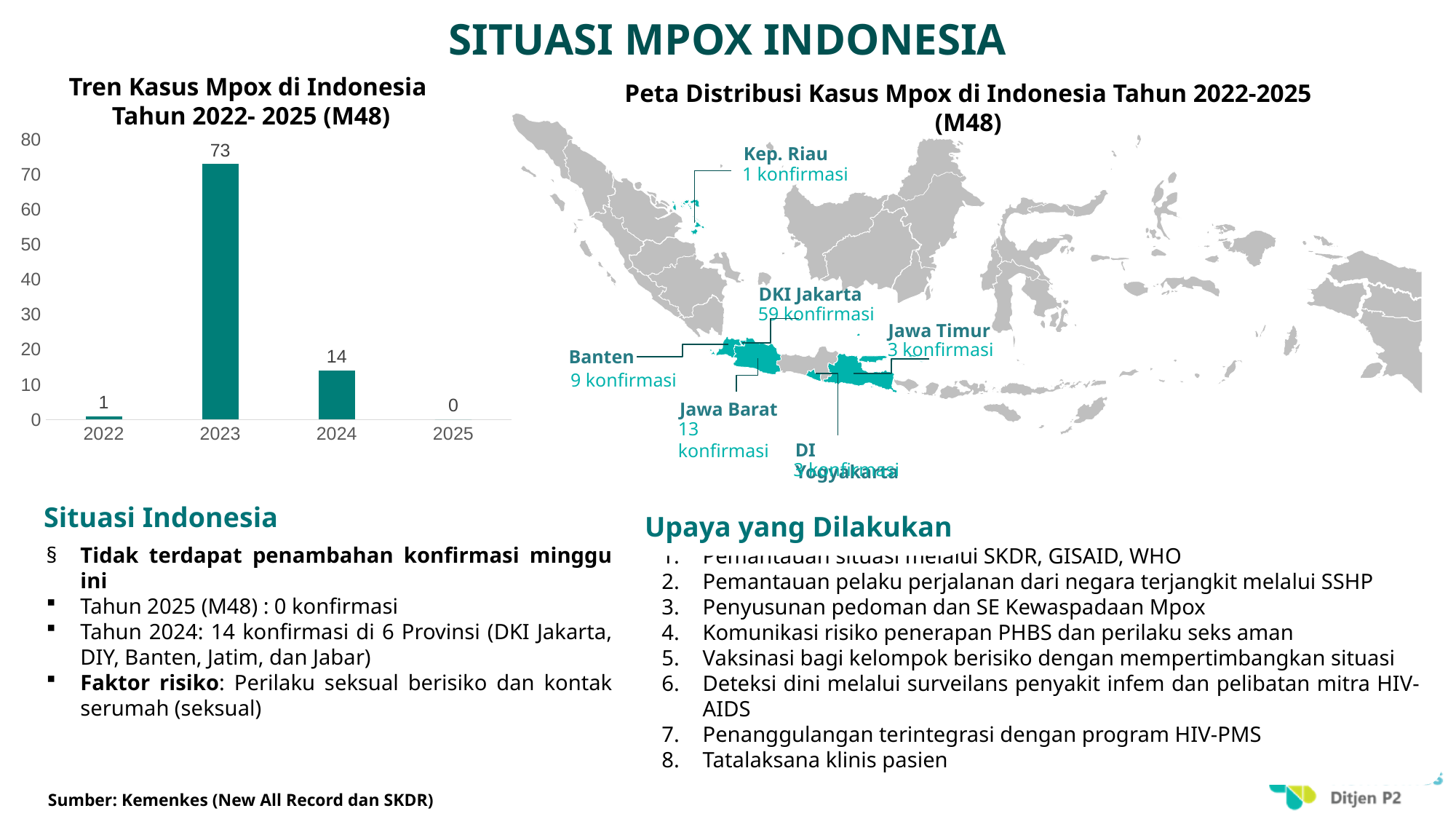
What kind of chart is 'Tren Kasus Mpox di Indonesia Tahun 2022-2025 (M48)'? bar chart In the bar chart 'Tren Kasus Mpox di Indonesia Tahun 2022-2025 (M48)', what is the value for 2025? 0 In the bar chart 'Tren Kasus Mpox di Indonesia Tahun 2022-2025 (M48)', what is the value for 2024? 14 In the bar chart 'Tren Kasus Mpox di Indonesia Tahun 2022-2025 (M48)', what is the value for 2023? 73 In the bar chart 'Tren Kasus Mpox di Indonesia Tahun 2022-2025 (M48)', what is the value for 2022? 1 In the bar chart 'Tren Kasus Mpox di Indonesia Tahun 2022-2025 (M48)', is the value for 2023 greater or less than 70? greater In the bar chart 'Tren Kasus Mpox di Indonesia Tahun 2022-2025 (M48)', do the values rise or fall from 2023 to 2025? fall In the bar chart 'Tren Kasus Mpox di Indonesia Tahun 2022-2025 (M48)', which year has the highest value? 2023 In the bar chart 'Tren Kasus Mpox di Indonesia Tahun 2022-2025 (M48)', what is the difference between the values for 2023 and 2024? 59 How many years are shown on the x axis of the bar chart 'Tren Kasus Mpox di Indonesia Tahun 2022-2025 (M48)'? 4 In the bar chart 'Tren Kasus Mpox di Indonesia Tahun 2022-2025 (M48)', which year has the lowest value? 2025 In the bar chart 'Tren Kasus Mpox di Indonesia Tahun 2022-2025 (M48)', which is larger, the value for 2022 or the value for 2024? 2024